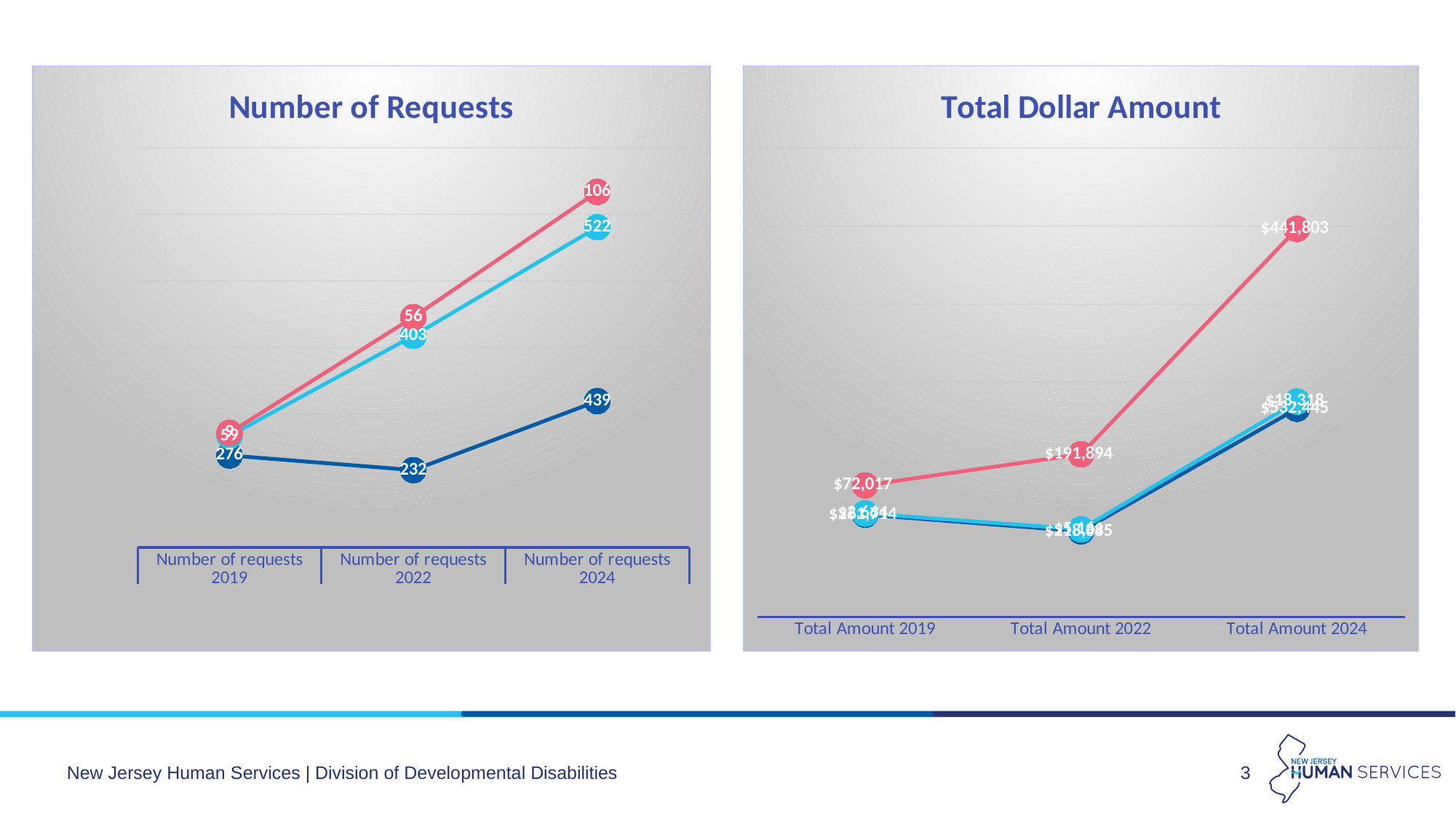
In the "Number of Requests" chart, what is the value of the dark blue line for Number of requests 2019? 276 In the "Number of Requests" chart, what is the value of the light blue line for Number of requests 2024? 522 In the "Total Dollar Amount" chart, does the pink line rise or fall from Total Amount 2019 to Total Amount 2024? rise In the "Total Dollar Amount" chart, what is the value of the pink line for Total Amount 2019? $72,017 In the "Total Dollar Amount" chart, what is the difference between the pink line's values for Total Amount 2024 and Total Amount 2022? $249,909 What kind of chart is the "Number of Requests" chart? line chart In the "Number of Requests" chart, what is the value of the pink line for Number of requests 2024? 106 In the "Number of Requests" chart, what is the value of the light blue line for Number of requests 2022? 403 In the "Total Dollar Amount" chart, what is the value of the pink line for Total Amount 2024? $441,803 In the "Number of Requests" chart, what is the value of the dark blue line for Number of requests 2022? 232 How many categories are shown on the x axis of the "Number of Requests" chart? 3 In the "Number of Requests" chart, what is the difference between the dark blue line's values for 2024 and 2019? 163